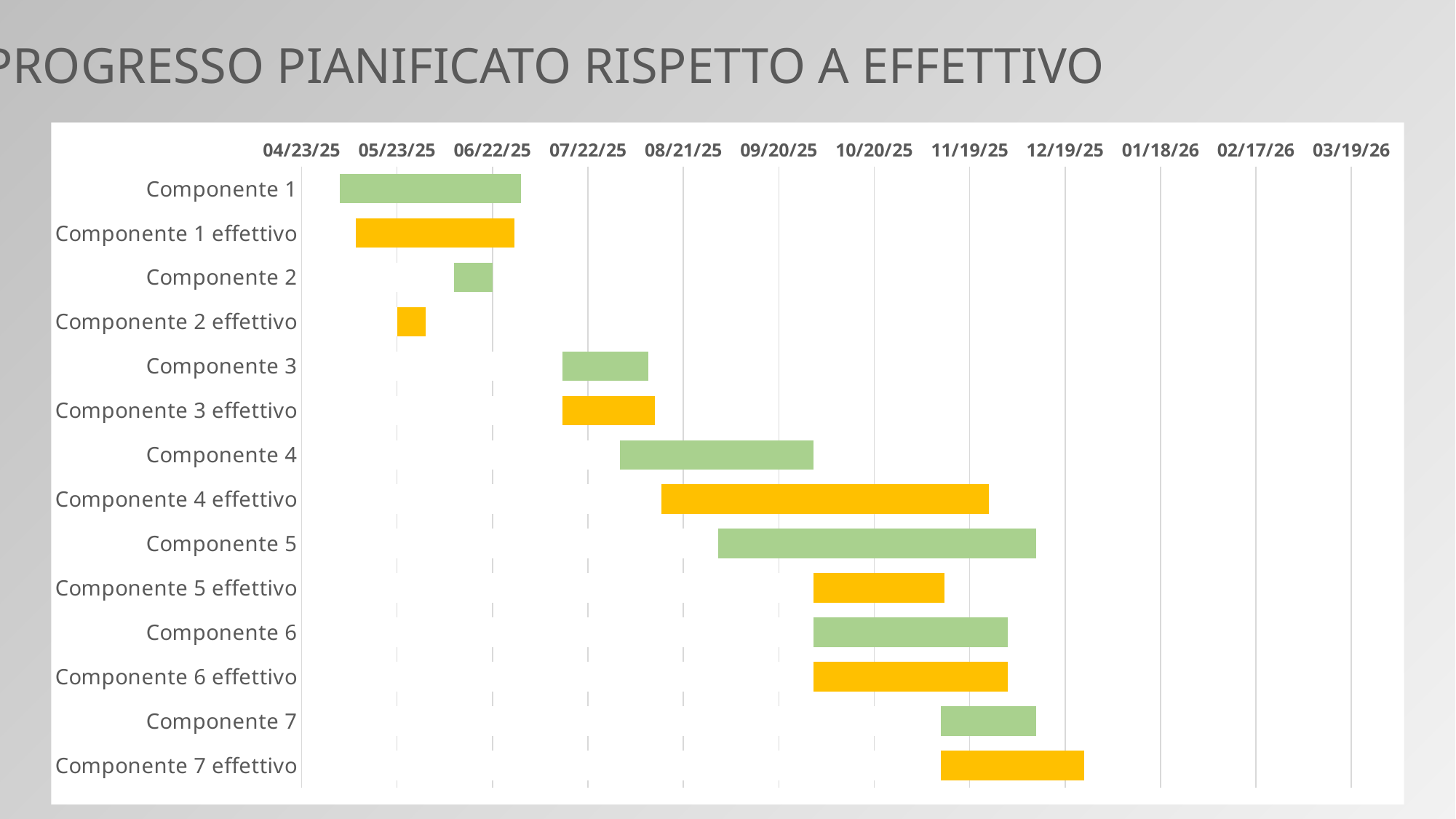
Does the Componente 7 effettivo bar end before or after 12/19/25? after Which bar starts earlier, Componente 1 or Componente 1 effettivo? Componente 1 Which bar is longer, Componente 4 or Componente 4 effettivo? Componente 4 effettivo What is the title of the slide? PROGRESSO PIANIFICATO RISPETTO A EFFETTIVO Does the Componente 1 bar start before or after 05/23/25? before What is the first date shown on the horizontal axis? 04/23/25 Which bar starts earlier, Componente 2 or Componente 2 effettivo? Componente 2 effettivo What colour are the bars for the 'effettivo' rows? yellow What kind of chart is shown on the slide? bar chart How many categories (rows) are listed on the vertical axis of the chart? 14